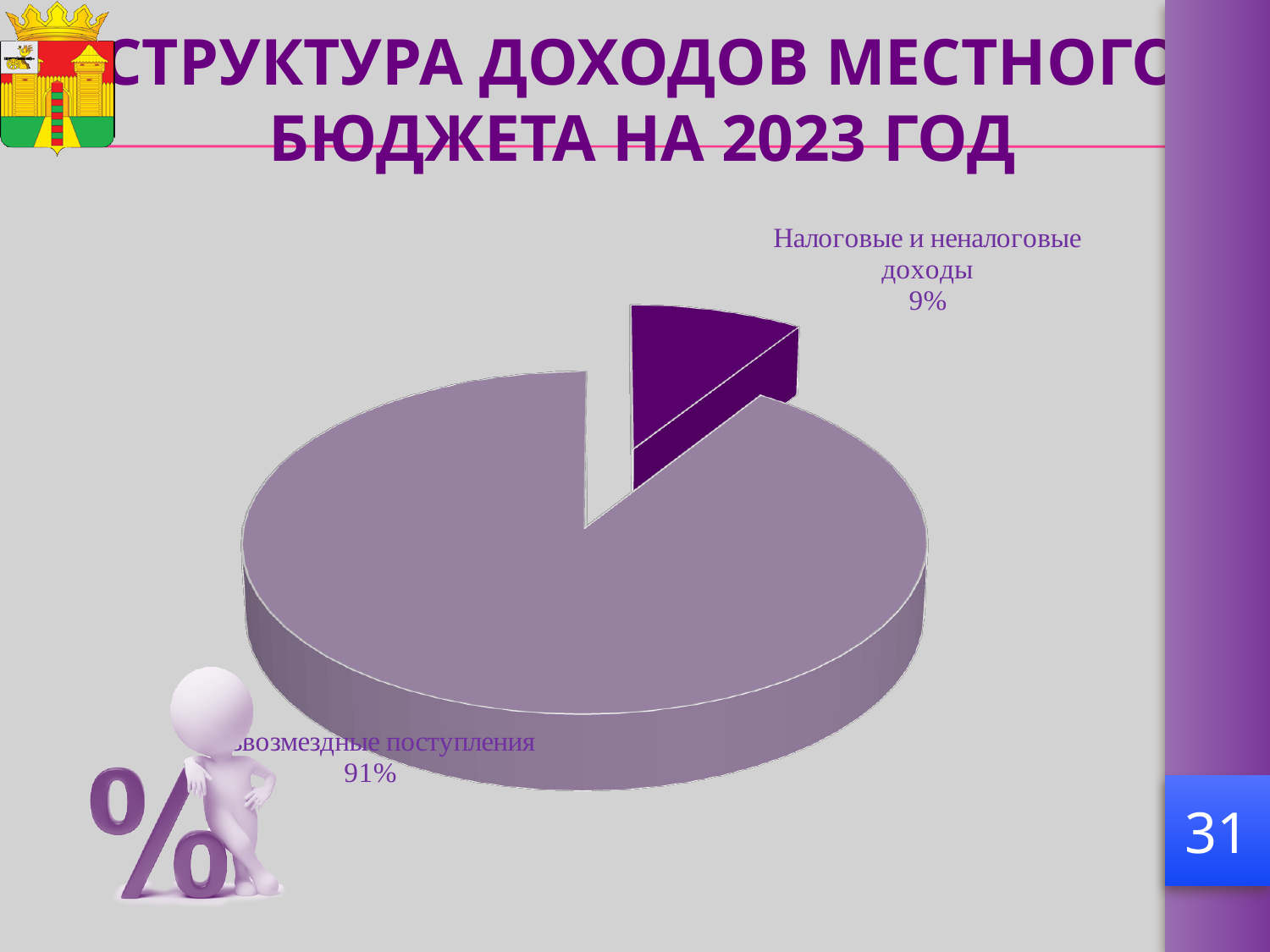
What share of the pie is labelled "Налоговые и неналоговые доходы"? 9% By how many percentage points does the "Безвозмездные поступления" share exceed the "Налоговые и неналоговые доходы" share? 82 percentage points What share of the pie is labelled "Безвозмездные поступления"? 91% Which category has the largest slice of the pie? Безвозмездные поступления Which category has the smallest slice of the pie? Налоговые и неналоговые доходы What do the two slice percentages add up to? 100% Which is larger: the share of "Налоговые и неналоговые доходы" or the share of "Безвозмездные поступления"? Безвозмездные поступления How many slices does the pie chart have? 2 What kind of chart is shown on the slide? Pie chart What is the title of the slide containing the pie chart? СТРУКТУРА ДОХОДОВ МЕСТНОГО БЮДЖЕТА НА 2023 ГОД What colour is the slice labelled 9%? Dark purple